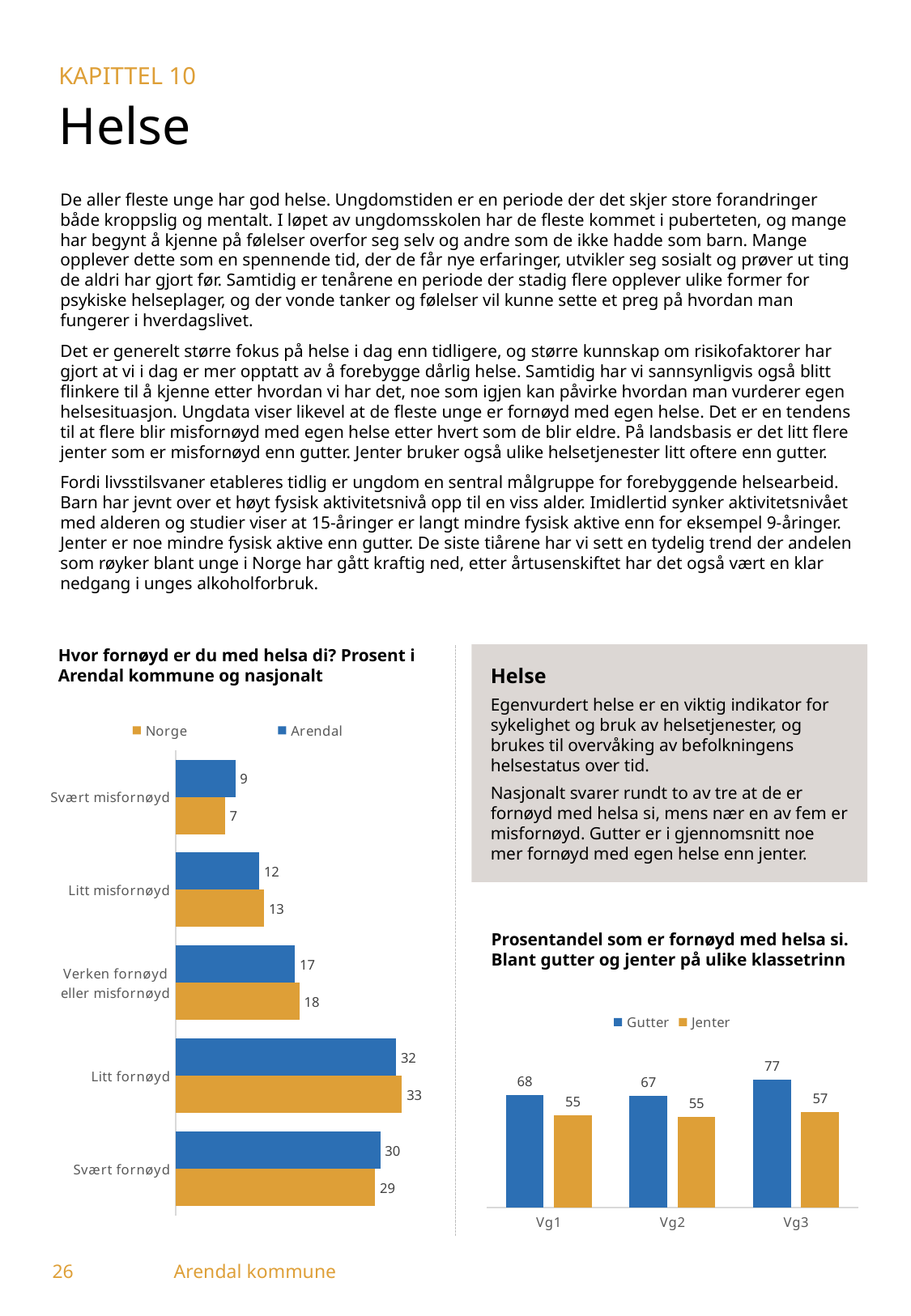
In the chart 'Hvor fornøyd er du med helsa di?', how many categories are shown? 5 In the chart 'Prosentandel som er fornøyd med helsa si', what is the Gutter value for Vg3? 77 In the chart 'Prosentandel som er fornøyd med helsa si', which is larger at Vg2: Gutter or Jenter? Gutter In the chart 'Hvor fornøyd er du med helsa di?', what is the Norge value for 'Svært misfornøyd'? 7 In the chart 'Prosentandel som er fornøyd med helsa si', what is the difference between Gutter and Jenter at Vg3? 20 In the chart 'Hvor fornøyd er du med helsa di?', which category has the lowest Arendal value? Svært misfornøyd In the chart 'Hvor fornøyd er du med helsa di?', what is the difference between the Norge and Arendal values for 'Verken fornøyd eller misfornøyd'? 1 What type of chart is 'Hvor fornøyd er du med helsa di?'? Bar chart In the chart 'Hvor fornøyd er du med helsa di?', which category has the highest Norge value? Litt fornøyd How many series does the legend of the chart 'Prosentandel som er fornøyd med helsa si' list? 2 In the chart 'Hvor fornøyd er du med helsa di?', what is the Arendal value for 'Litt fornøyd'? 32 In the chart 'Prosentandel som er fornøyd med helsa si', what is the Jenter value for Vg1? 55